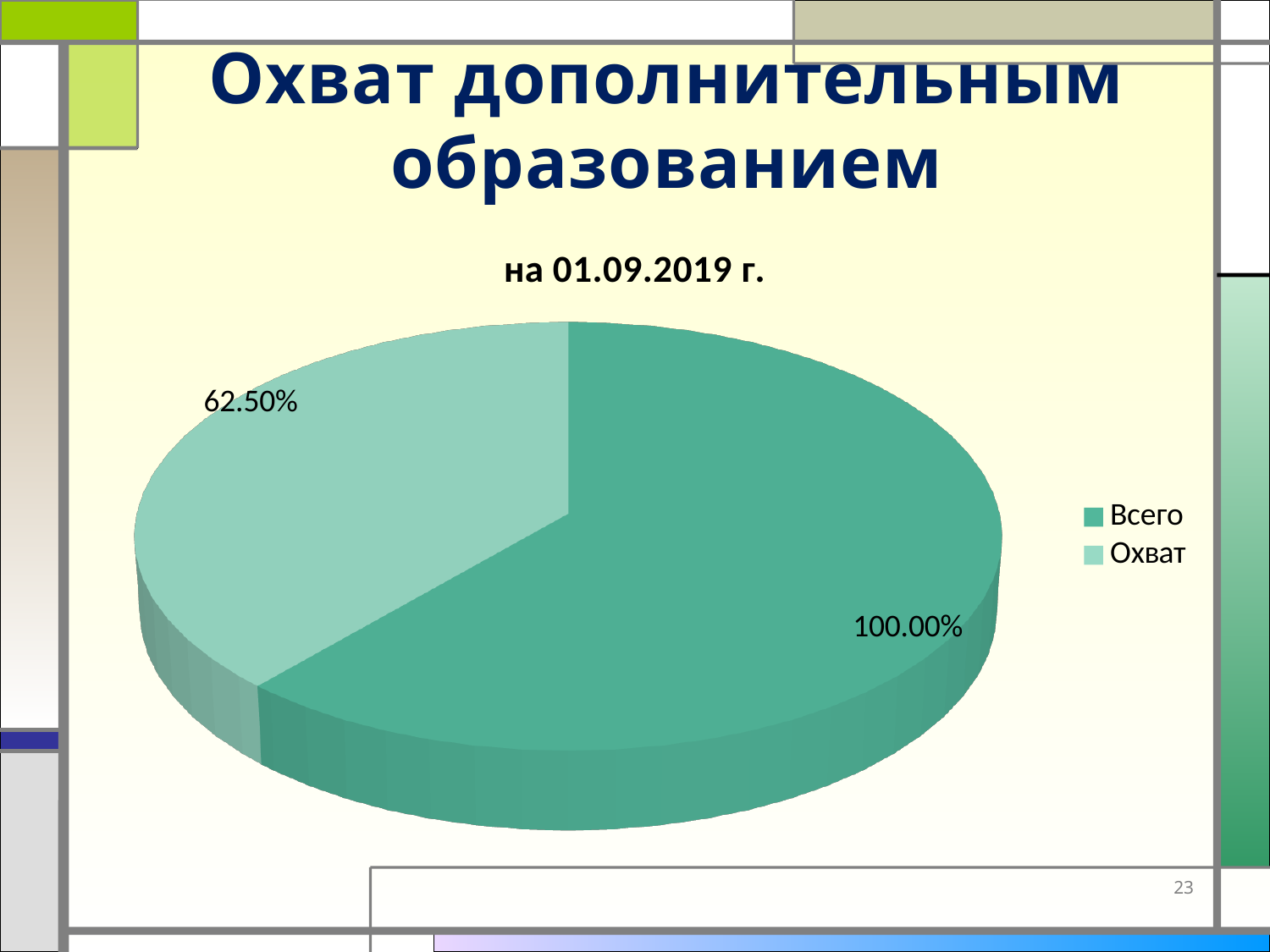
Which slice takes up the larger portion of the pie? Всего What is the difference between the labelled values for Всего and Охват? 37.50% How many entries does the legend list? 2 Which slice has the larger labelled value, Всего or Охват? Всего What kind of chart is shown on the slide? Pie chart Which category has the highest labelled value? Всего Which legend entry is shown in the lighter green colour? Охват How many slices does the pie chart have? 2 What is the value labelled on the Охват slice? 62.50% What is the title of the chart? на 01.09.2019 г. Which category has the lowest labelled value? Охват What is the value labelled on the Всего slice? 100.00%